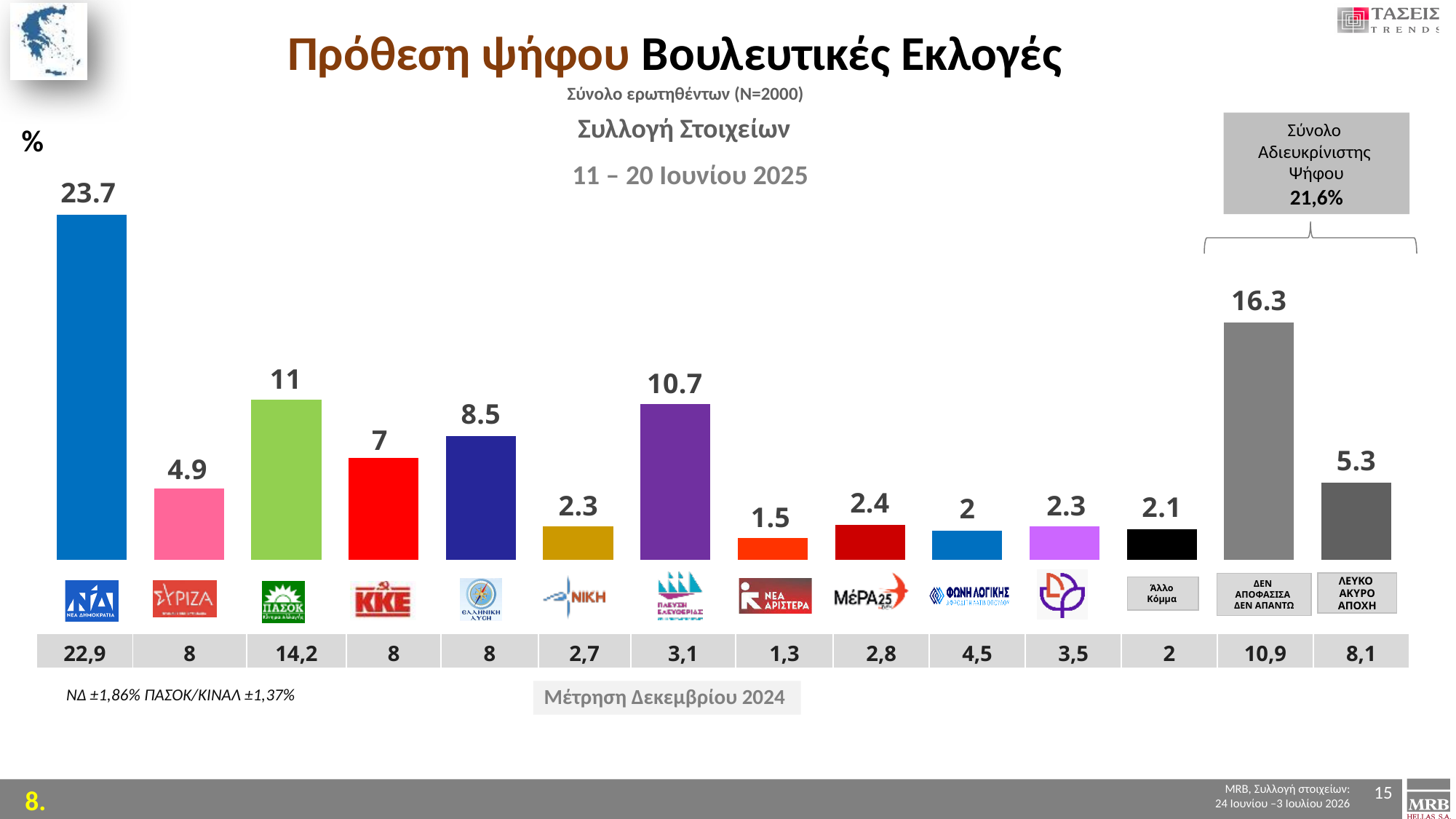
Which category has the lowest value in the chart? ΝΕΑ ΑΡΙΣΤΕΡΑ Which party has the highest value in the chart? ΝΔ (Νέα Δημοκρατία) What is the value shown for ΝΔ (Νέα Δημοκρατία)? 23.7 What is the value shown for ΠΛΕΥΣΗ ΕΛΕΥΘΕΡΙΑΣ? 10.7 Which has a larger value, ΚΚΕ or ΕΛΛΗΝΙΚΗ ΛΥΣΗ? ΕΛΛΗΝΙΚΗ ΛΥΣΗ What is the value shown for ΔΕΝ ΑΠΟΦΑΣΙΣΑ / ΔΕΝ ΑΠΑΝΤΩ? 16.3 What was the value for ΣΥΡΙΖΑ in the December 2024 measurement (Μέτρηση Δεκεμβρίου 2024) row? 8 What is the total of undecided vote (Σύνολο Αδιευκρίνιστης Ψήφου) shown in the box? 21,6% How many bars are shown in the chart? 14 What type of chart is shown on the slide? Bar chart What is the difference between the values for ΝΔ and ΠΑΣΟΚ? 12.7 What is the value shown for ΠΑΣΟΚ? 11